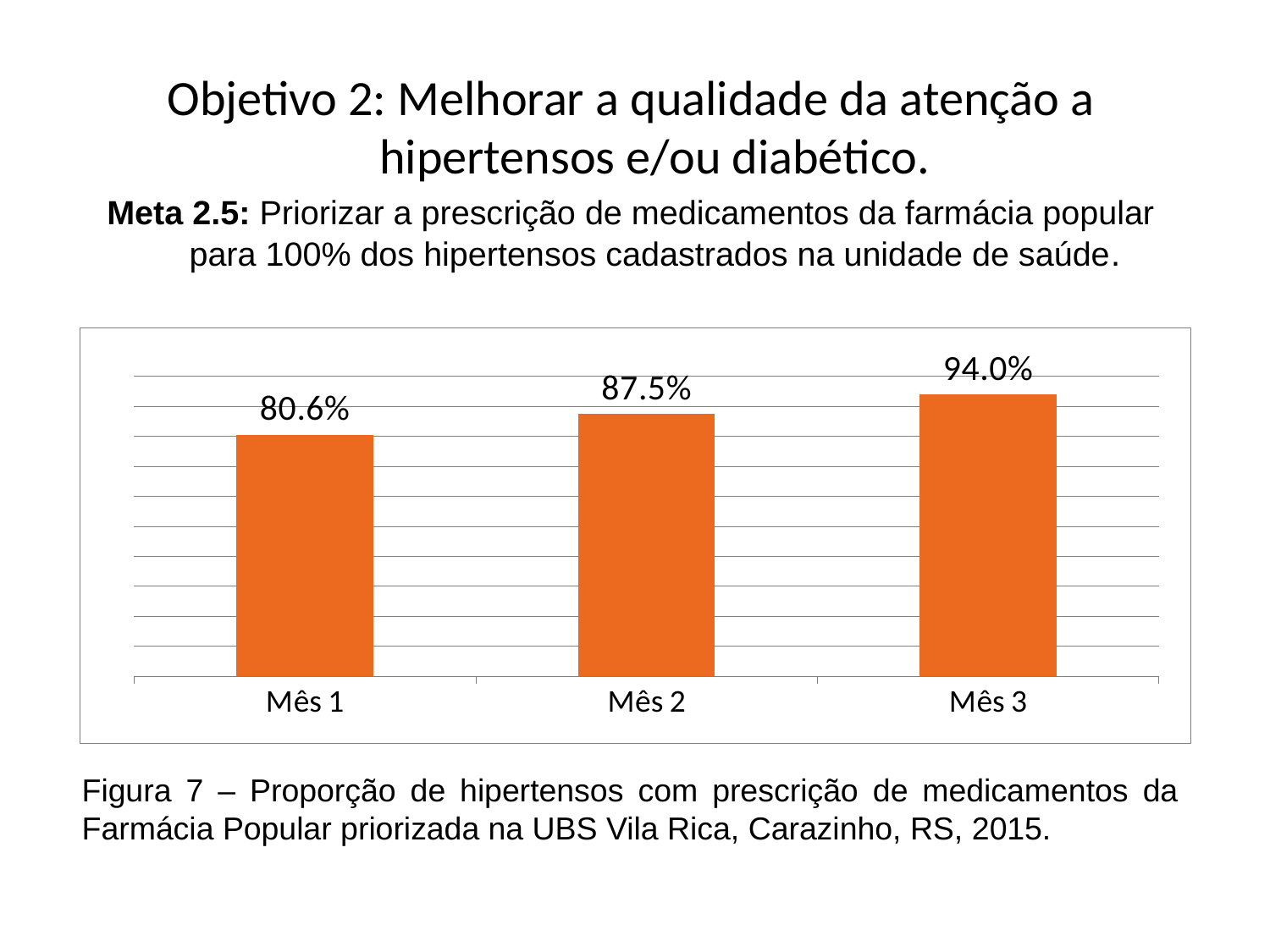
Which month has the lowest value? Mês 1 What is the value for Mês 2? 87.5% What is the value for Mês 1? 80.6% What kind of chart is shown on the slide? Bar chart Which month has the highest value? Mês 3 What colour are the bars in the chart? Orange Do the values rise or fall from Mês 1 to Mês 3? Rise How many months are shown on the x axis? 3 Which is larger, the value for Mês 2 or the value for Mês 3? Mês 3 What is the value for Mês 3? 94.0% What is the difference between the values for Mês 2 and Mês 1? 6.9% What is the difference between the values for Mês 3 and Mês 1? 13.4%